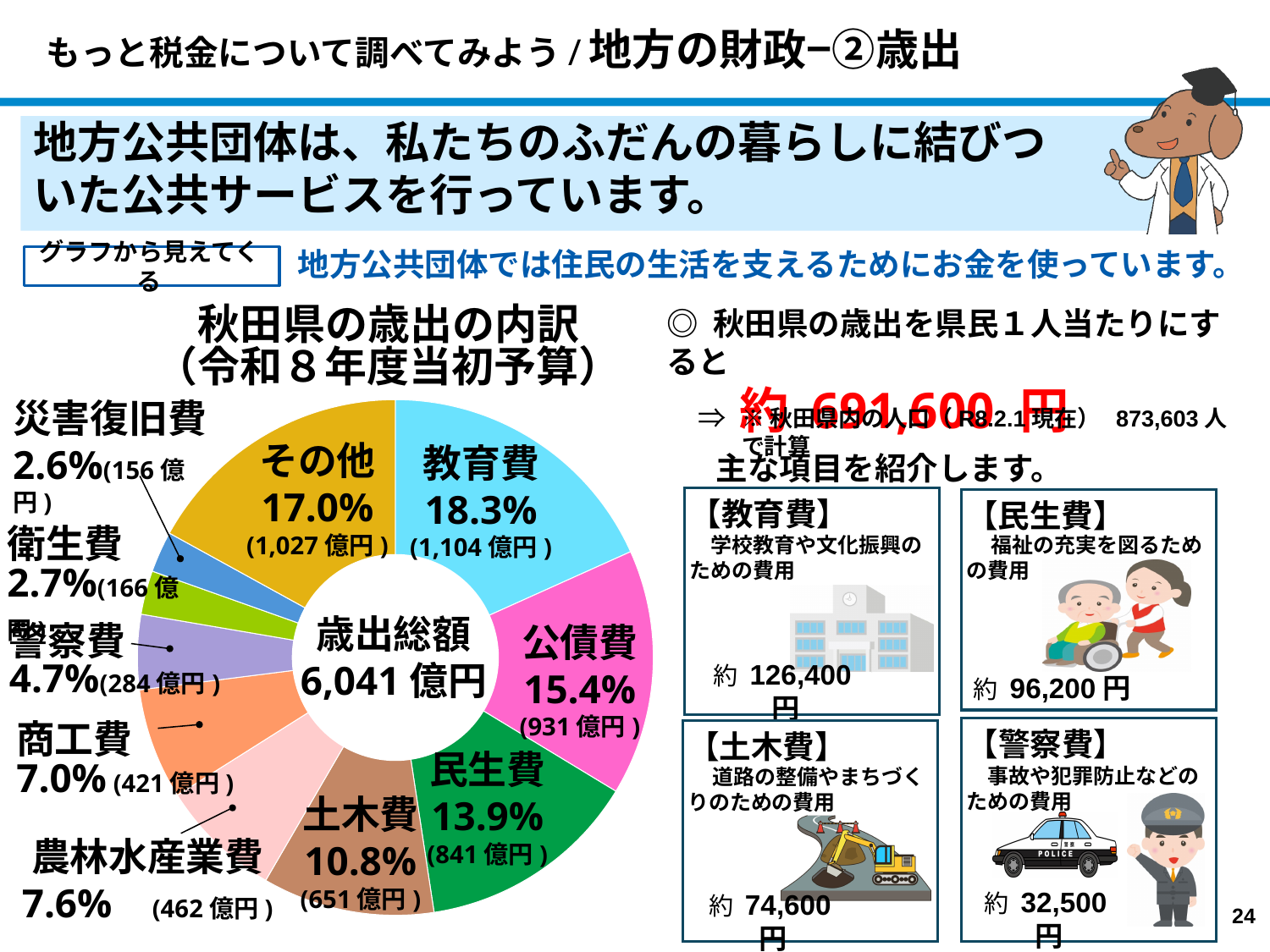
「秋田県の歳出の内訳」のグラフで、警察費の金額はいくらですか？ 284億円 「秋田県の歳出の内訳」のグラフの中央に示されている歳出総額はいくらですか？ 6,041億円 「秋田県の歳出の内訳」のグラフで、教育費と公債費の割合の差は何ポイントですか？ 2.9ポイント 「秋田県の歳出の内訳」のグラフはどの種類のグラフですか？ 円グラフ 「秋田県の歳出の内訳」のグラフで、教育費の割合は何％ですか？ 18.3% 「秋田県の歳出の内訳」のグラフで、公債費の金額はいくらですか？ 931億円 「秋田県の歳出の内訳」のグラフで、その他と農林水産業費の金額の差はいくらですか？ 565億円 「秋田県の歳出の内訳」のグラフで、民生費と土木費ではどちらの割合が大きいですか？ 民生費 「秋田県の歳出の内訳」のグラフは、何年度の予算を示していますか？ 令和8年度当初予算 「秋田県の歳出の内訳」のグラフで、土木費の割合は何％ですか？ 10.8% 「秋田県の歳出の内訳」のグラフで、最も割合が大きい項目はどれですか？ 教育費 「秋田県の歳出の内訳」のグラフには、いくつの項目がありますか？ 10